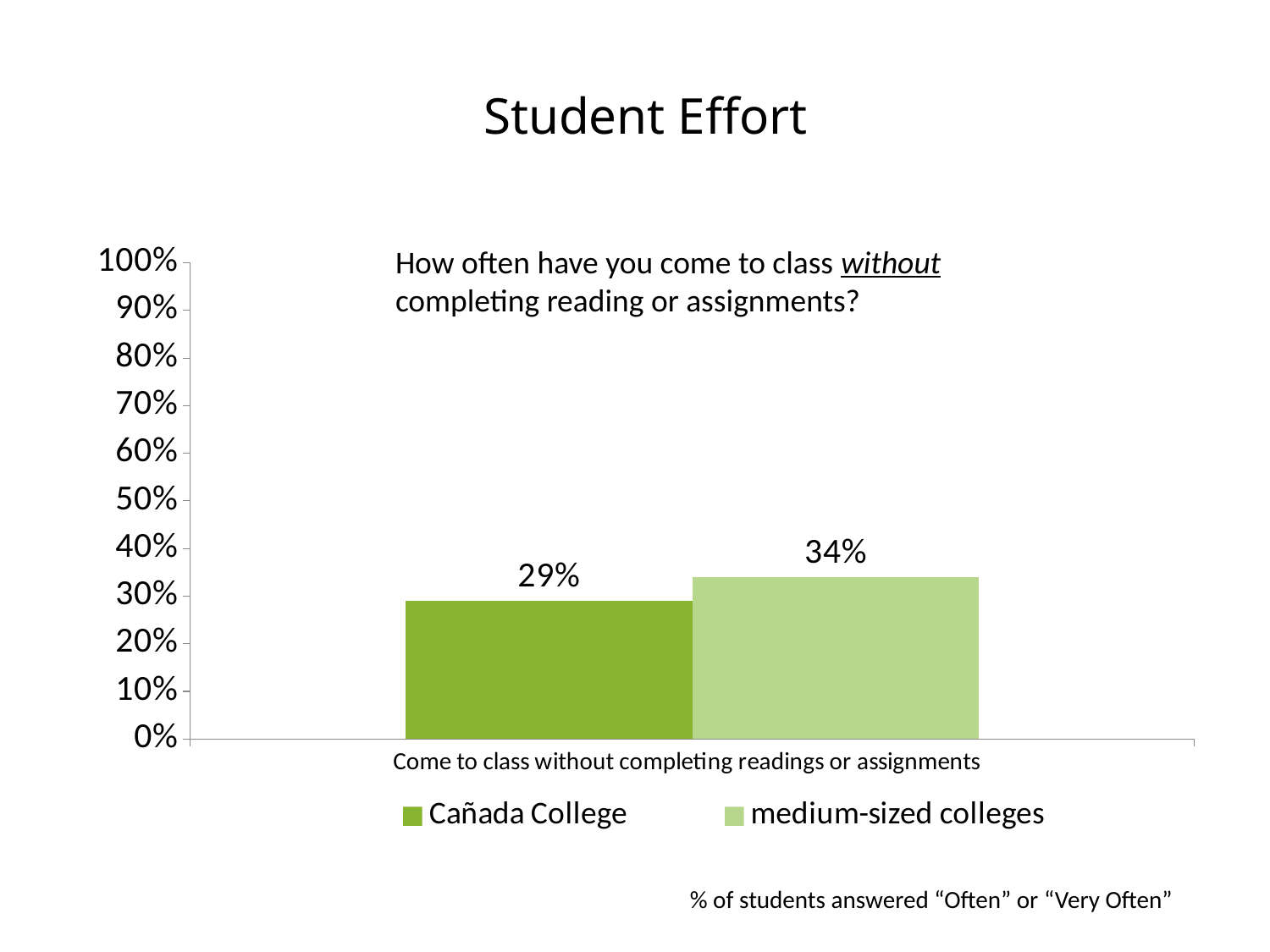
Is the value for medium-sized colleges greater or less than 50%? less What is the value for medium-sized colleges? 34% What kind of chart is shown? bar chart What is the title of the slide? Student Effort What is the value for Cañada College? 29% What is the category label on the x axis? Come to class without completing readings or assignments Is the value for Cañada College greater or less than 20%? greater Which series has the higher value? medium-sized colleges How many series does the legend list? 2 What is the difference between the medium-sized colleges value and the Cañada College value? 5% Which series has the lower value? Cañada College Is the value for Cañada College larger or smaller than the value for medium-sized colleges? smaller